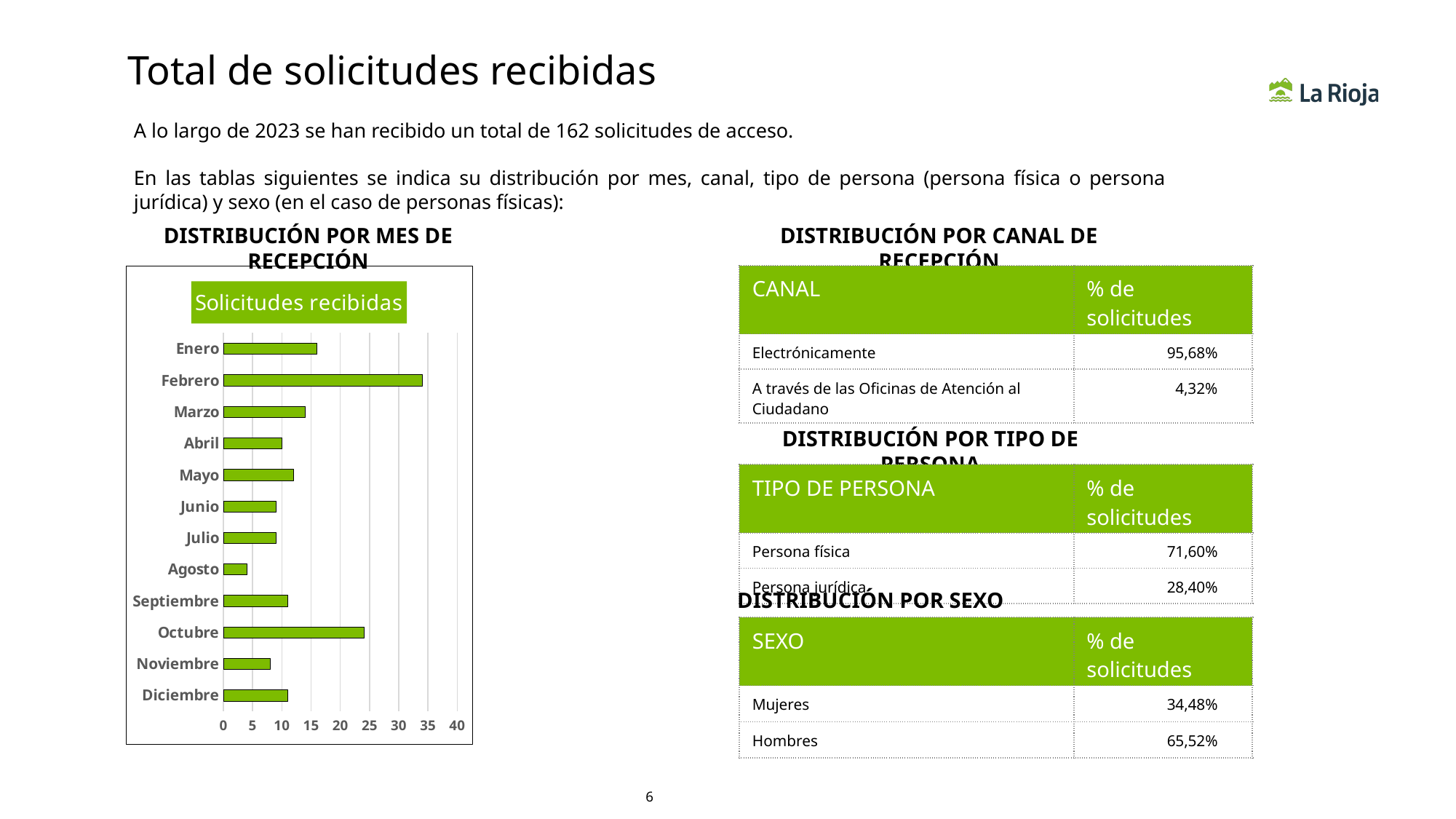
Which month has the highest number of solicitudes recibidas in the bar chart? Febrero In the bar chart, is the value for Febrero greater or less than 30? greater In the bar chart, is the value for Mayo greater or less than 10? greater In the bar chart, which month has more solicitudes recibidas, Febrero or Octubre? Febrero How many months (categories) are shown in the bar chart? 12 In the bar chart, is the value for Agosto greater or less than 5? less What kind of chart is shown under the heading 'DISTRIBUCIÓN POR MES DE RECEPCIÓN'? bar chart Which month has the lowest number of solicitudes recibidas in the bar chart? Agosto In the bar chart, which month has more solicitudes recibidas, Octubre or Enero? Octubre